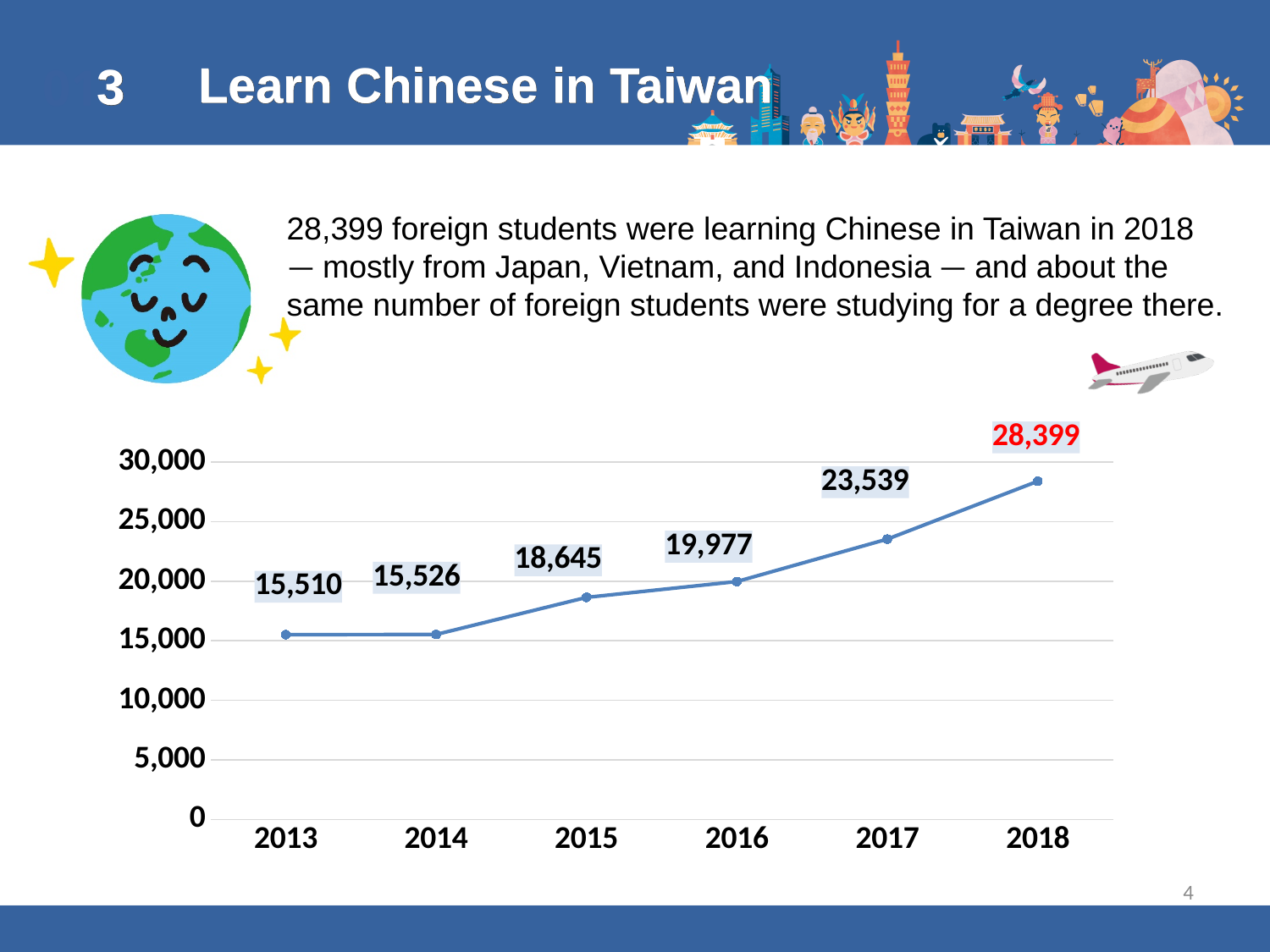
What is the value for 2018? 28,399 Is the value for 2017 greater or less than 20,000? greater What is the difference between the values for 2018 and 2017? 4,860 Which year has the highest value? 2018 What is the difference between the values for 2015 and 2014? 3,119 What kind of chart is shown on the slide? line chart What is the value for 2013? 15,510 What is the value for 2016? 19,977 How many years are plotted on the chart? 6 Which is larger, the value for 2016 or the value for 2015? 2016 Which year has the lowest value? 2013 Do the values rise or fall from 2013 to 2018? rise